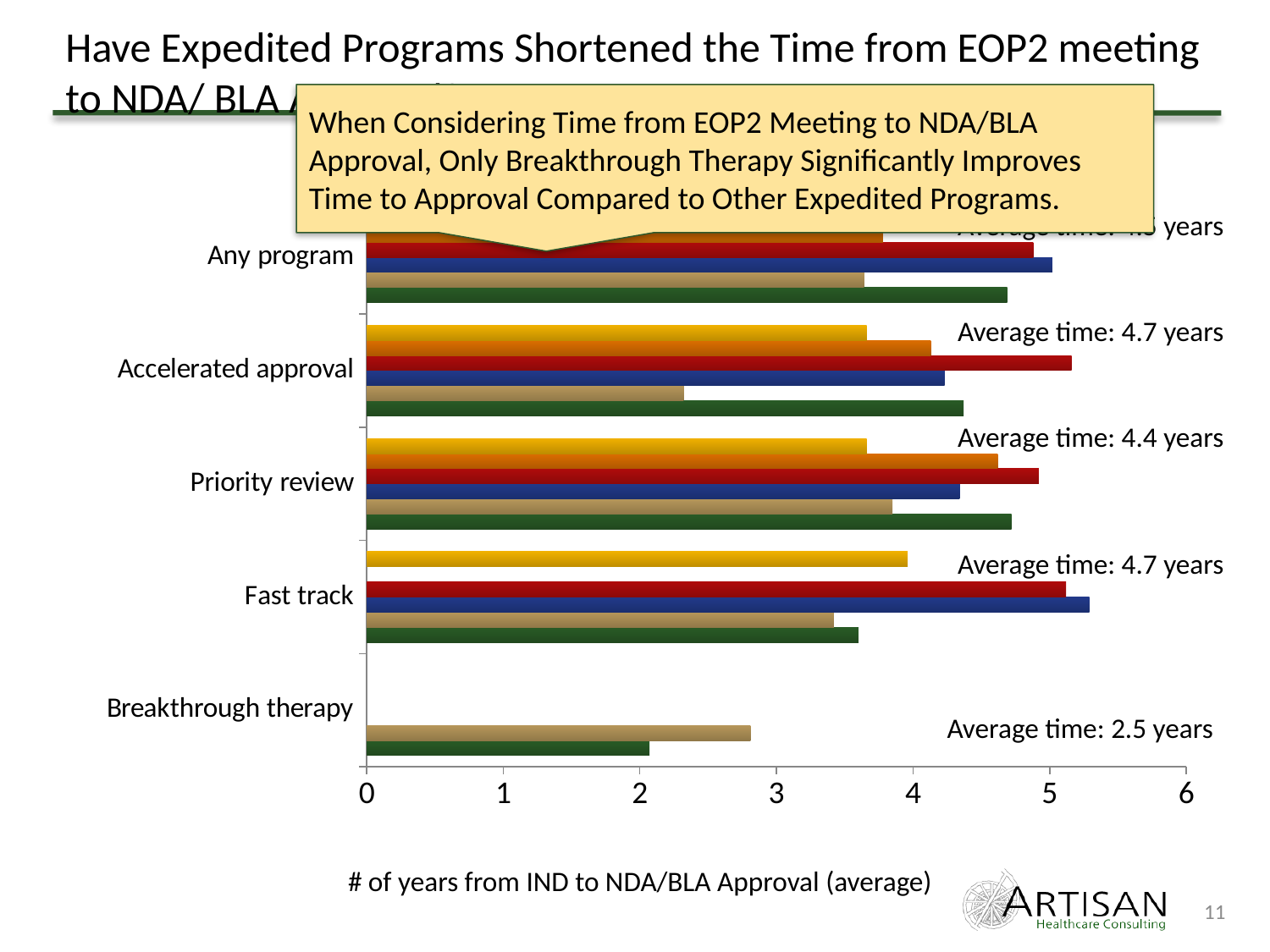
What is the title of the horizontal axis of the chart? # of years from IND to NDA/BLA Approval (average) How many program categories are listed on the vertical axis of the chart? 5 What kind of chart is shown on the slide? Bar chart What is the average time shown for Fast track? 4.7 years What is the average time shown for Priority review? 4.4 years Which program has the lowest average time shown on the chart? Breakthrough therapy Is the longest bar for Breakthrough therapy greater or less than 3? less What is the difference between the average time for Fast track and the average time for Breakthrough therapy? 2.2 years Which has a longer average time, Accelerated approval or Priority review? Accelerated approval What is the average time shown for Accelerated approval? 4.7 years What is the average time shown for Breakthrough therapy? 2.5 years Is the longest bar for Fast track greater or less than 5? greater